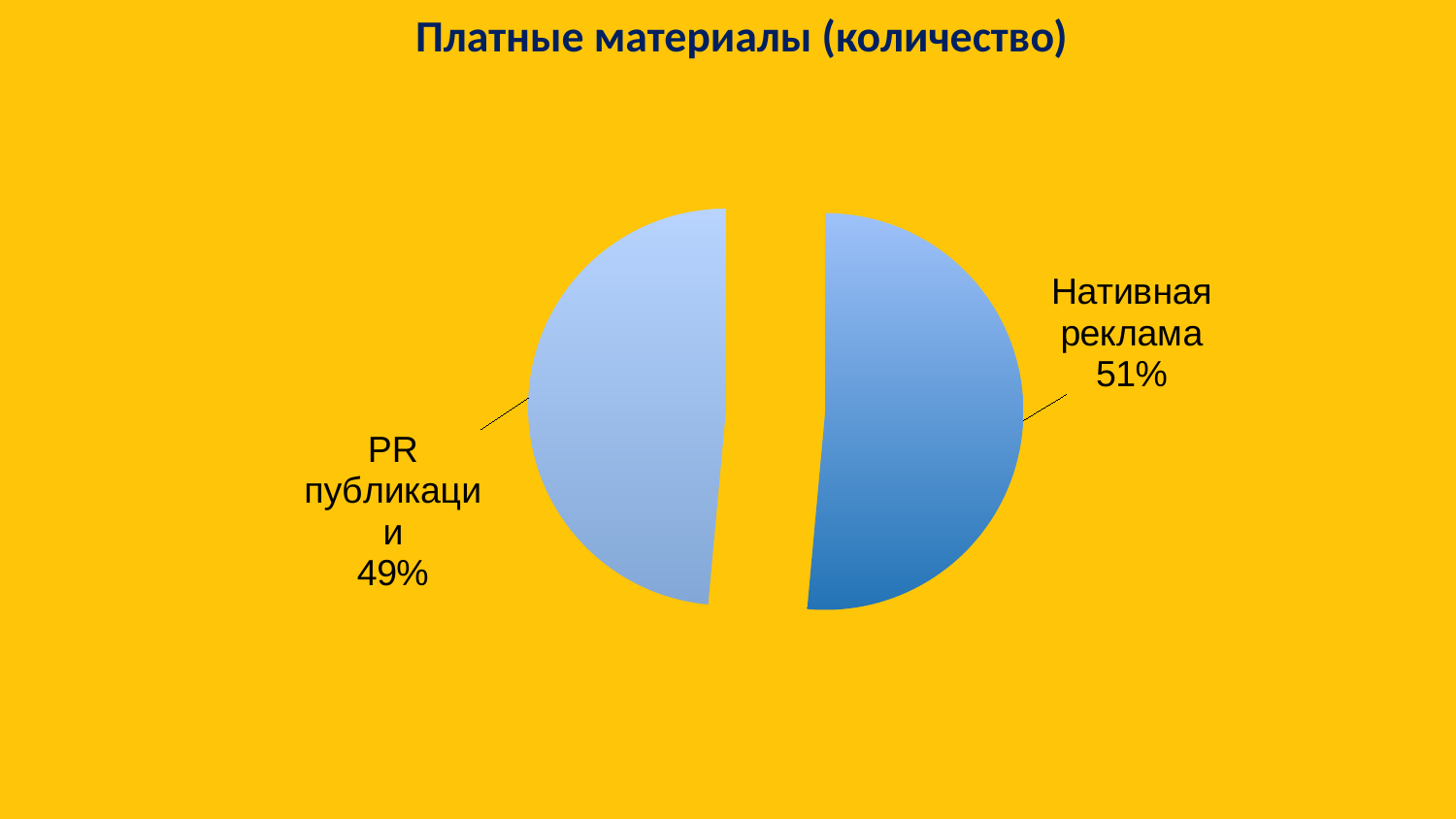
What share of the pie does PR публикации have? 49% What share of the pie does Нативная реклама have? 51% What is the total of the two slices shown? 100% Which slice is the smallest? PR публикации What is the title of the chart? Платные материалы (количество) What kind of chart is shown on the slide? pie chart How many slices does the pie chart have? 2 What is the difference in percentage points between Нативная реклама and PR публикации? 2% Is the share for PR публикации greater or less than 50%? less Which is larger, the share for Нативная реклама or the share for PR публикации? Нативная реклама Is the share for Нативная реклама greater or less than 50%? greater Which slice is the largest? Нативная реклама